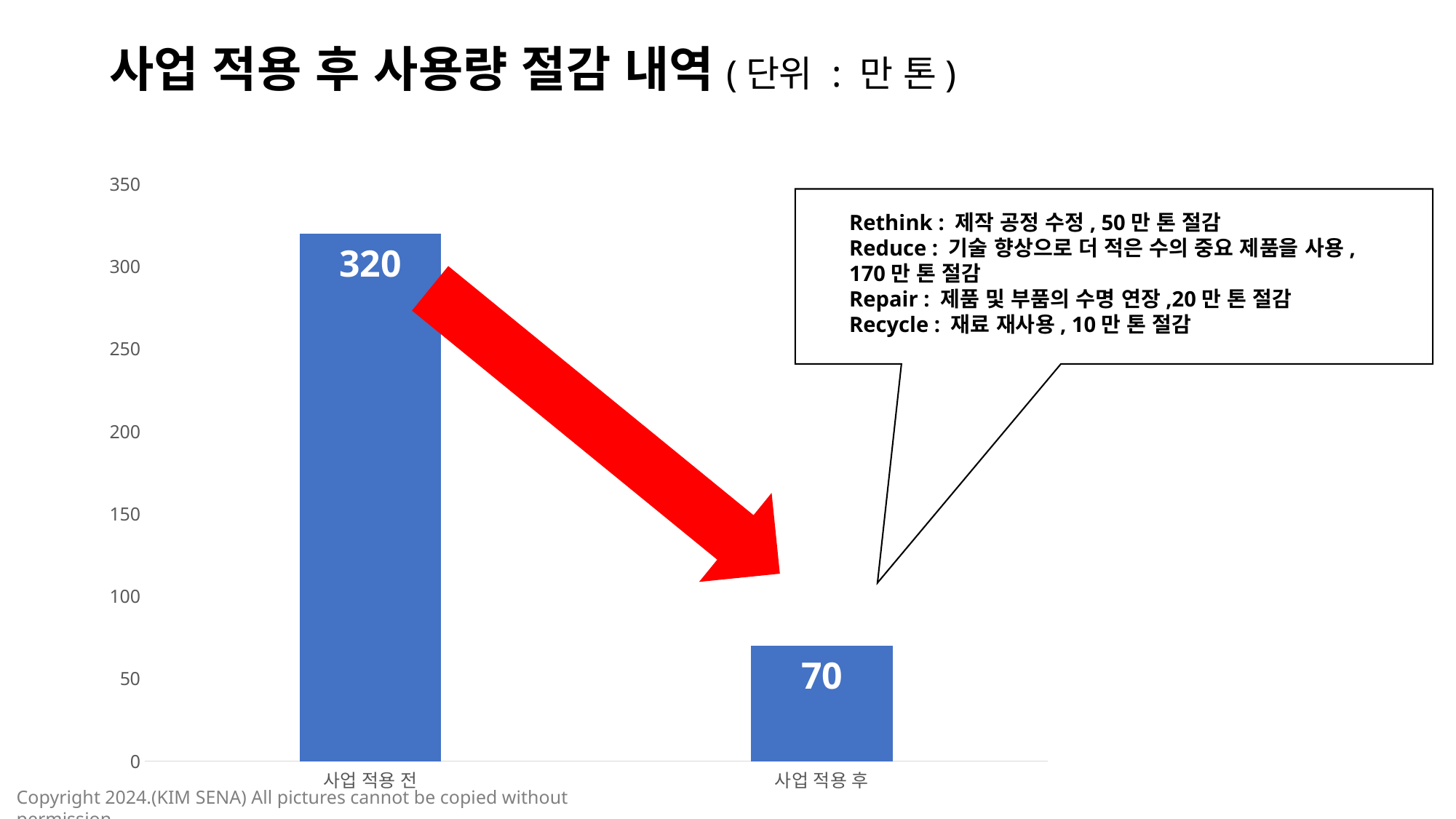
What is the value for 사업 적용 전? 320 Which is larger, the value for 사업 적용 전 or 사업 적용 후? 사업 적용 전 Do the values rise or fall from 사업 적용 전 to 사업 적용 후? fall What is the value for 사업 적용 후? 70 How many categories are shown on the x axis? 2 Which category has the highest value? 사업 적용 전 What is the difference between the values for 사업 적용 전 and 사업 적용 후? 250 Which category has the lowest value? 사업 적용 후 Is the value for 사업 적용 전 greater or less than 300? greater What kind of chart is shown on the slide? bar chart Is the value for 사업 적용 후 greater or less than 100? less What unit is given in the slide title? 만 톤